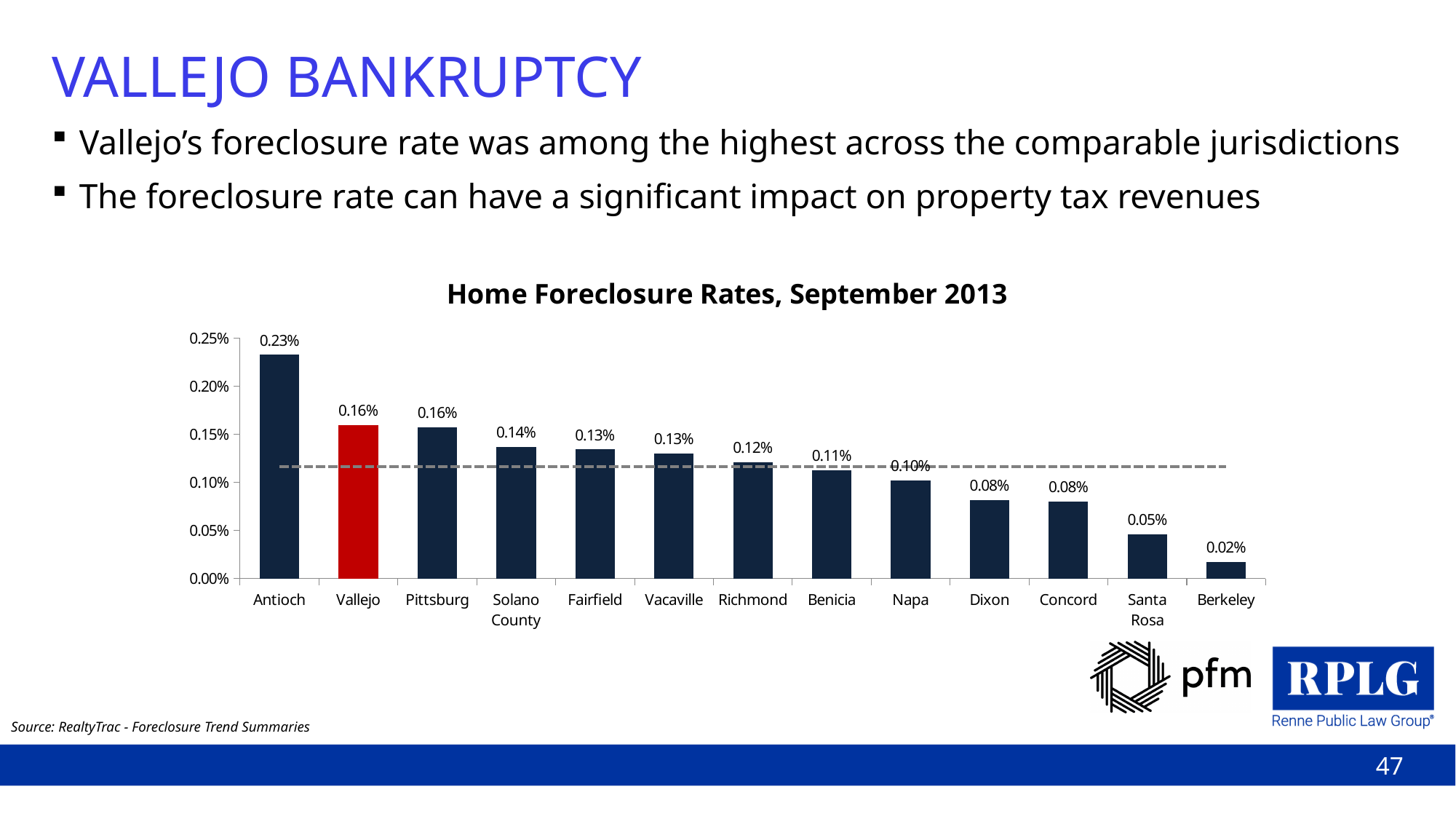
What is the home foreclosure rate for Vallejo? 0.16% What is the difference between the foreclosure rates of Antioch and Vallejo? 0.07% How many jurisdictions are shown in the chart? 13 Which jurisdiction has the lowest home foreclosure rate? Berkeley Which bar in the chart is highlighted in red? Vallejo What is the home foreclosure rate for Antioch? 0.23% What kind of chart is shown on the slide? Bar chart Is the foreclosure rate for Richmond greater or less than 0.10%? greater Do the foreclosure rates rise or fall from left to right across the chart? Fall Which jurisdiction has the highest home foreclosure rate? Antioch What is the home foreclosure rate for Santa Rosa? 0.05% Which has a higher foreclosure rate, Solano County or Napa? Solano County